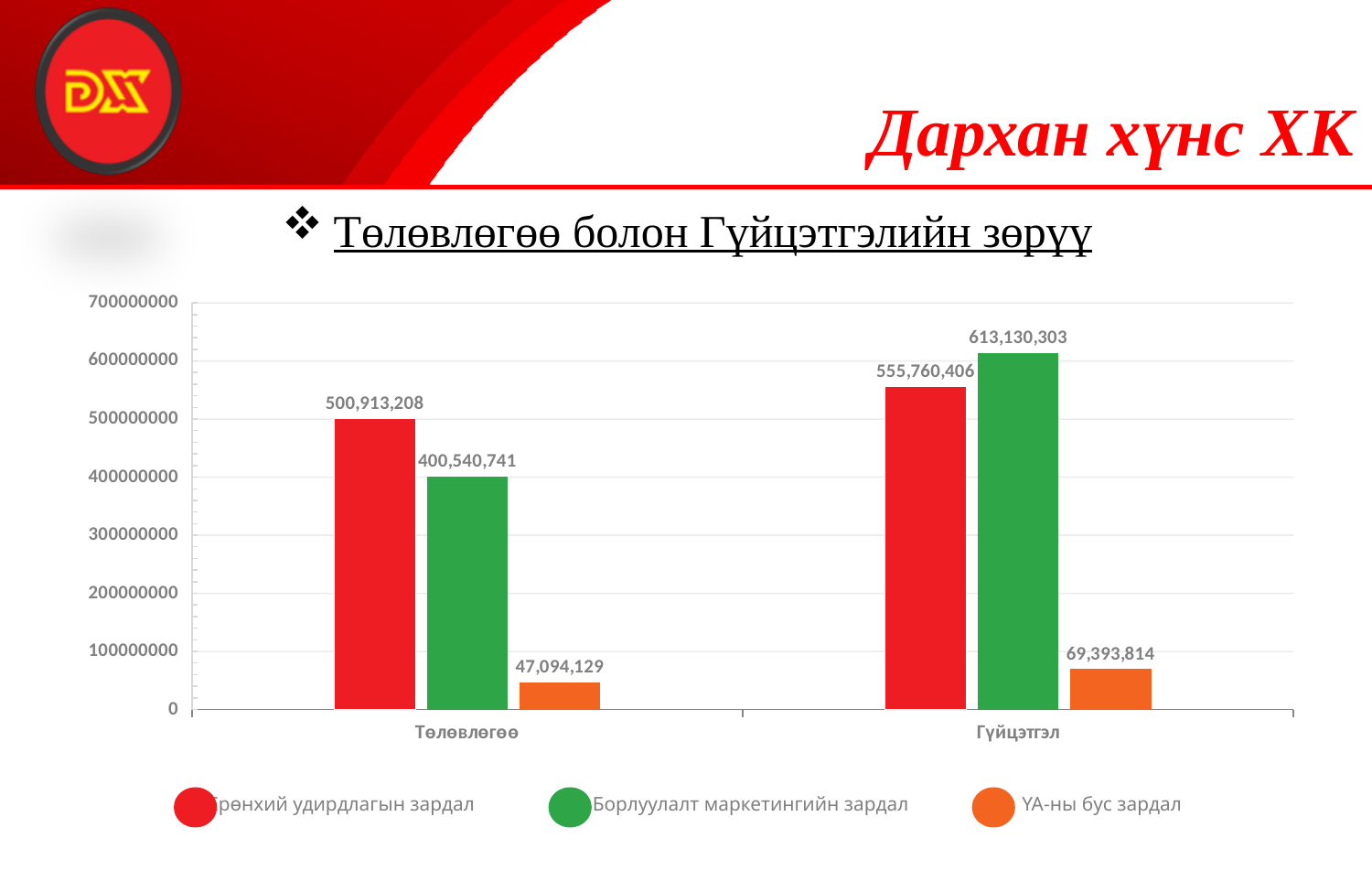
What is the value of ҮА-ны бус зардал for Гүйцэтгэл? 69,393,814 How many categories are shown on the x axis? 2 Which series has the highest value in the Гүйцэтгэл category? Борлуулалт маркетингийн зардал What is the value of Борлуулалт маркетингийн зардал for Төлөвлөгөө? 400,540,741 How many series does the legend list? 3 What is the difference between the red series values for Гүйцэтгэл and Төлөвлөгөө? 54,847,198 What is the value of ҮА-ны бус зардал for Төлөвлөгөө? 47,094,129 What is the difference between the Борлуулалт маркетингийн зардал values for Гүйцэтгэл and Төлөвлөгөө? 212,589,562 What type of chart is shown on the slide? Bar chart What is the value of the red series for Гүйцэтгэл? 555,760,406 Which is larger: the red series value for Төлөвлөгөө or the Борлуулалт маркетингийн зардал value for Төлөвлөгөө? The red series value for Төлөвлөгөө Which series has the lowest value in the Төлөвлөгөө category? ҮА-ны бус зардал